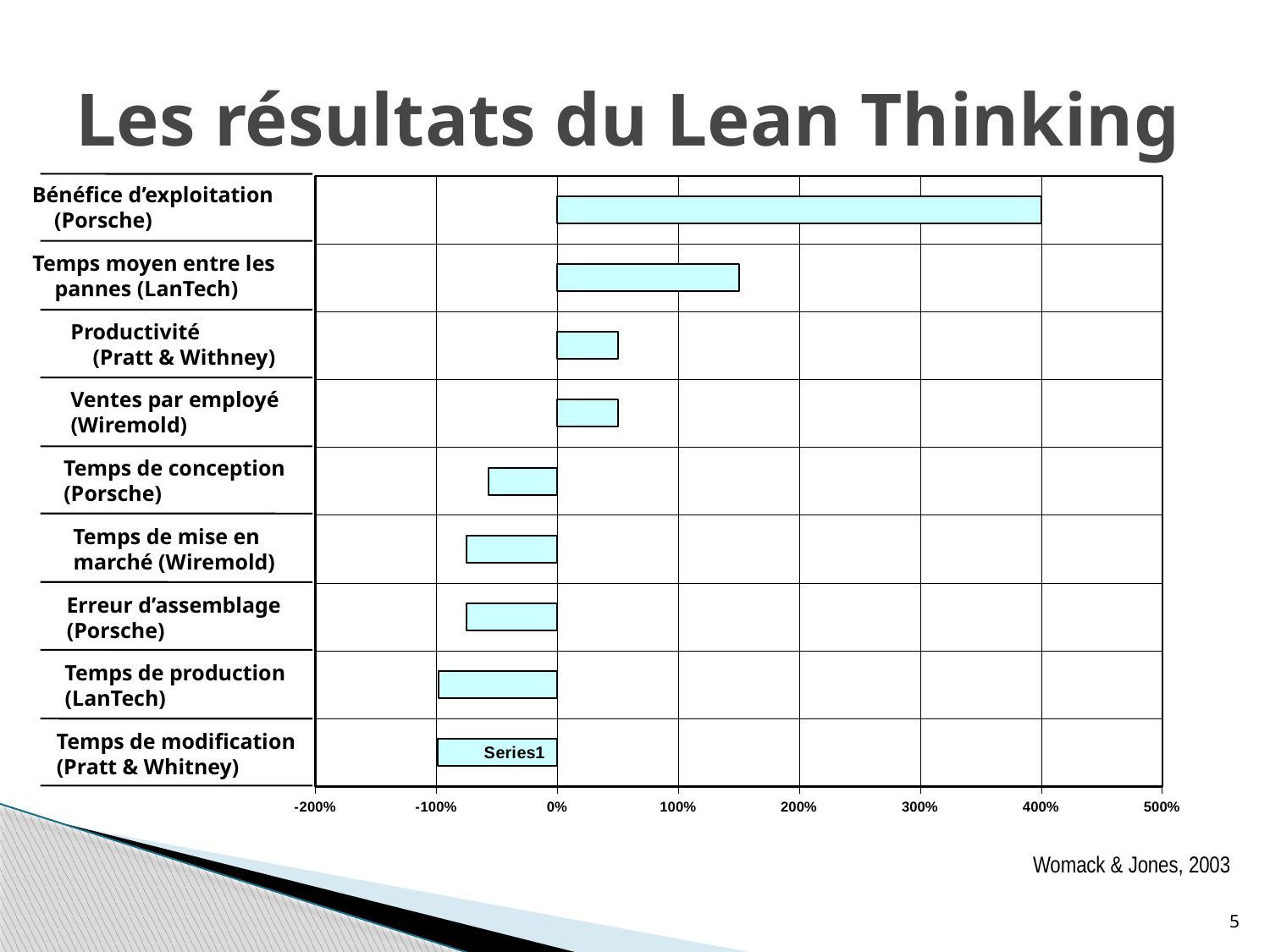
Which is larger, the value for Temps de conception (Porsche) or the value for Temps de production (LanTech)? Temps de conception (Porsche) What kind of chart is shown on the slide? bar chart What is the title of the slide containing the chart? Les résultats du Lean Thinking How many categories are plotted in the chart? 9 Is the value for Temps de conception (Porsche) greater or less than 0%? less Is the value for Productivité (Pratt & Withney) greater or less than 100%? less Which category has the highest value in the chart? Bénéfice d'exploitation (Porsche) Is the value for Temps de mise en marché (Wiremold) greater or less than -100%? greater What is the value for Bénéfice d'exploitation (Porsche)? 400% Which is larger, the value for Bénéfice d'exploitation (Porsche) or the value for Temps moyen entre les pannes (LanTech)? Bénéfice d'exploitation (Porsche)